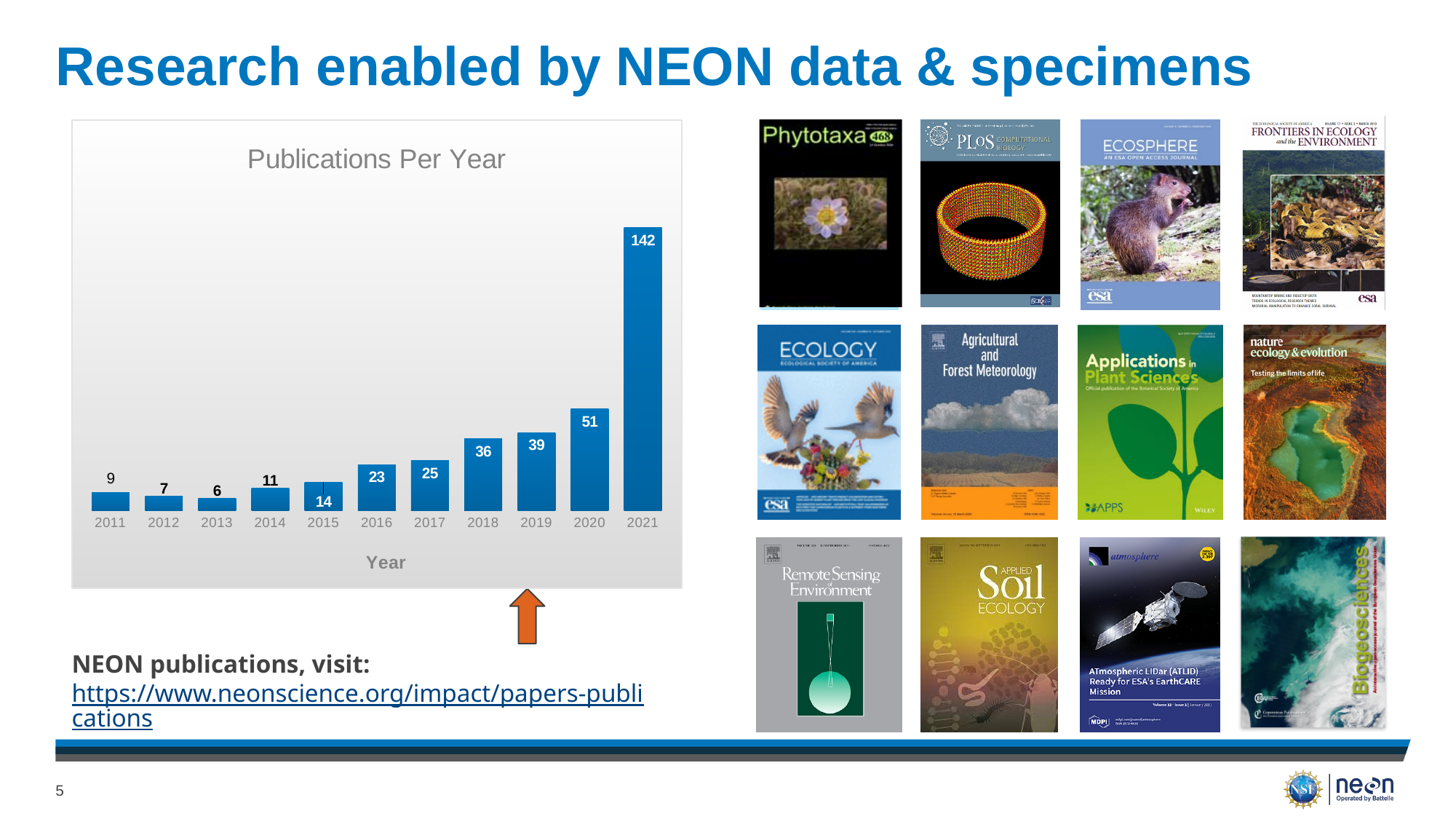
What kind of chart is Publications Per Year? bar chart What is the value for 2013? 6 What is the difference between the values for 2019 and 2018? 3 Which year has the highest number of publications? 2021 What is the title of the chart? Publications Per Year How many publications are shown for 2016? 23 Do the values generally rise or fall from 2013 to 2021? rise How many years are shown on the x axis of the chart? 11 What is the value for 2021 in the Publications Per Year chart? 142 Which year has the lowest number of publications? 2013 Which is larger, the value for 2014 or the value for 2015? 2015 What is the difference between the values for 2021 and 2020? 91